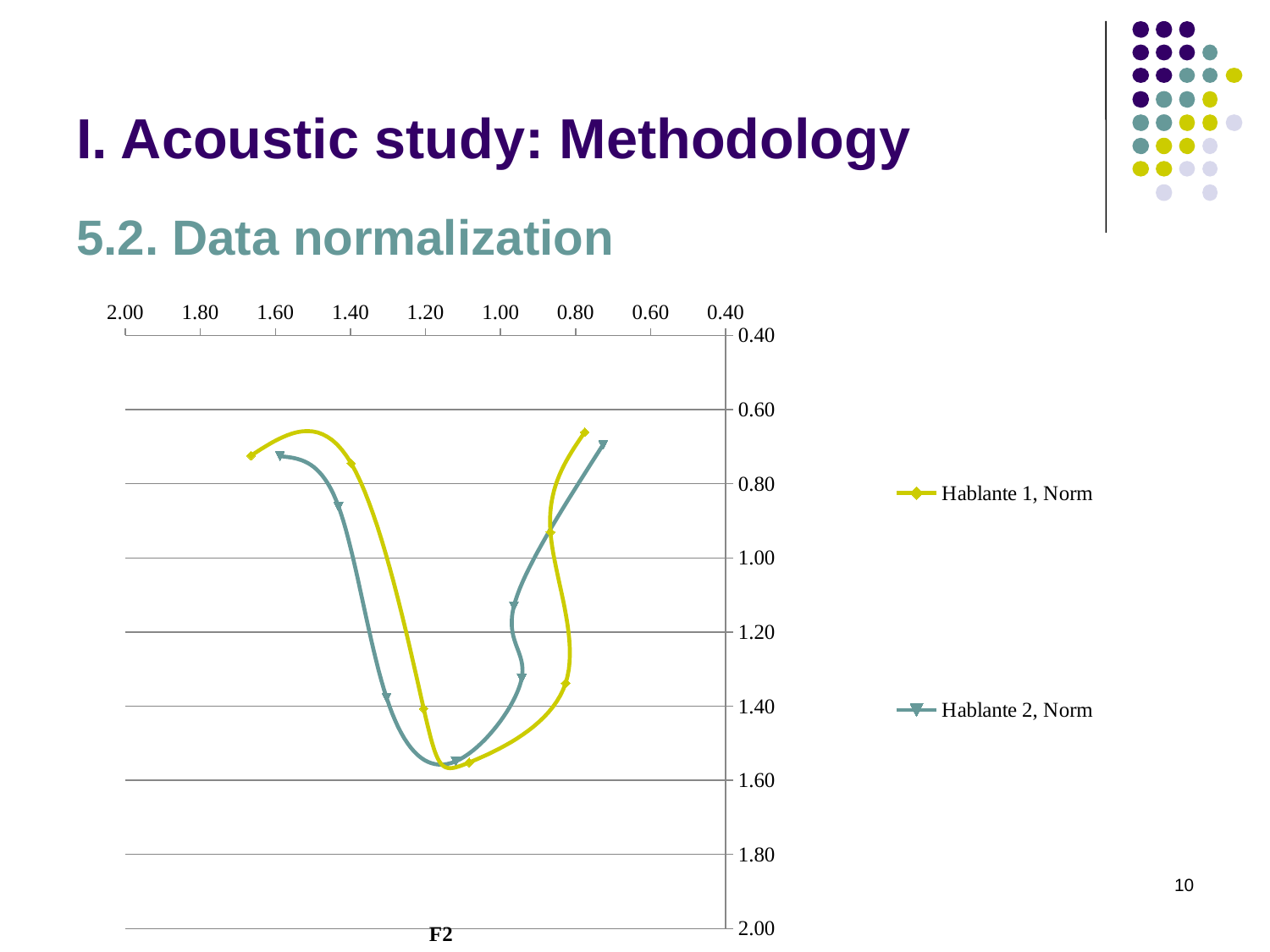
What is the title of the horizontal axis? F2 What is the spacing between consecutive tick labels on the vertical axis? 0.20 What kind of chart is shown on the slide? line chart What is the smallest value shown on the horizontal axis? 0.40 How many series does the legend list? 2 Is the largest vertical-axis value reached by the Hablante 1, Norm series greater or less than 1.40? greater What is the largest value shown on the vertical axis? 2.00 Is the smallest vertical-axis value reached by the Hablante 1, Norm series greater or less than 0.60? greater What are the names of the two series in the legend? Hablante 1, Norm and Hablante 2, Norm Is the largest vertical-axis value reached by the Hablante 2, Norm series greater or less than 1.80? less